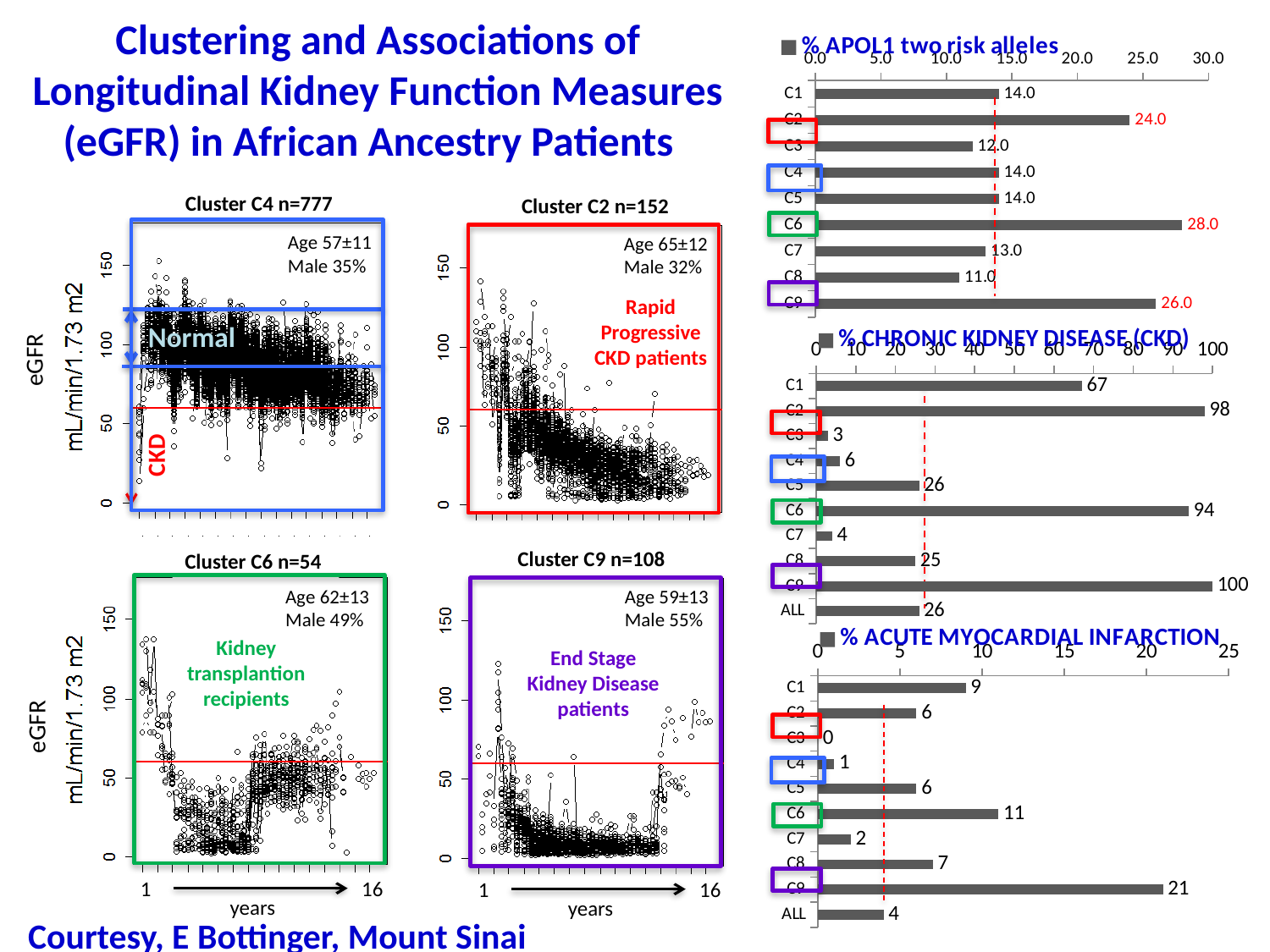
In the "% APOL1 two risk alleles" chart, what is the value for C6? 28.0 In the "% ACUTE MYOCARDIAL INFARCTION" chart, what is the value for C3? 0 In the "% CHRONIC KIDNEY DISEASE (CKD)" chart, how many categories are plotted? 10 What kind of chart is the "% APOL1 two risk alleles" chart? Bar chart In the "% APOL1 two risk alleles" chart, which cluster has the lowest value? C8 In the "% ACUTE MYOCARDIAL INFARCTION" chart, what is the difference between C9 and C8? 14 In the "% APOL1 two risk alleles" chart, what is the difference between C9 and C2? 2.0 In the "% ACUTE MYOCARDIAL INFARCTION" chart, which category has the highest value? C9 In the "% ACUTE MYOCARDIAL INFARCTION" chart, which is larger, C1 or C6? C6 In the "% CHRONIC KIDNEY DISEASE (CKD)" chart, what is the value for ALL? 26 In the "% CHRONIC KIDNEY DISEASE (CKD)" chart, which category has the lowest value? C3 In the "% CHRONIC KIDNEY DISEASE (CKD)" chart, what is the value for C9? 100